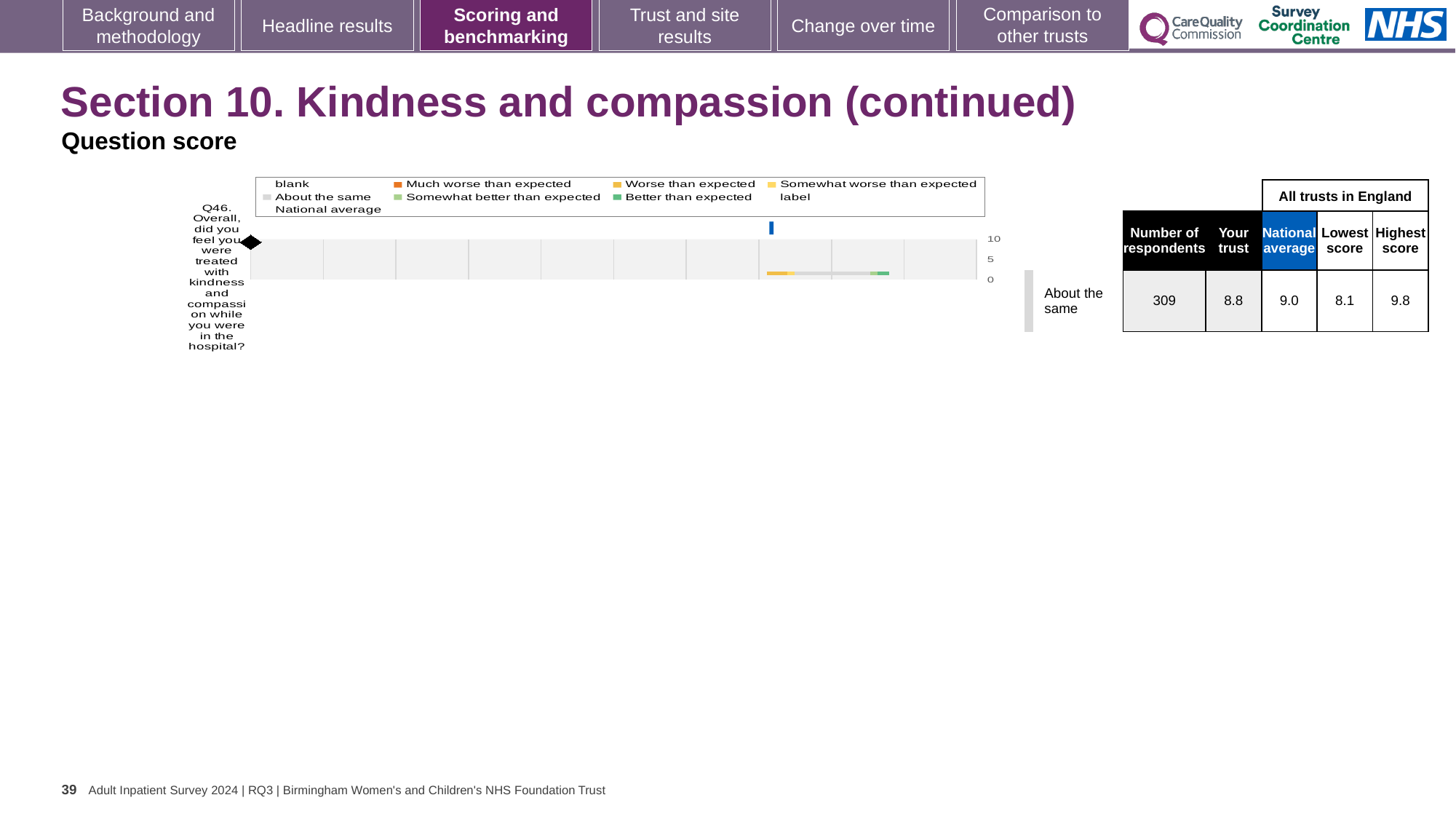
How many respondents are listed for Q46 in the table beside the chart? 309 For Q46, what is the difference between the highest score and the lowest score among all trusts in England? 1.7 In the table beside the chart, what is the 'Your trust' score for Q46? 8.8 In the table beside the chart, what is the national average score for Q46? 9.0 What is the highest tick value shown on the chart's value axis? 10 In the table beside the chart, what is the lowest score among all trusts in England for Q46? 8.1 How many questions (categories) are plotted on the chart? 1 How many entries does the chart legend list? 9 What kind of chart is shown on the slide? bar chart Which question number is plotted on the chart? Q46 In the table beside the chart, what is the highest score among all trusts in England for Q46? 9.8 For Q46, which is larger: the 'Your trust' score or the national average? National average